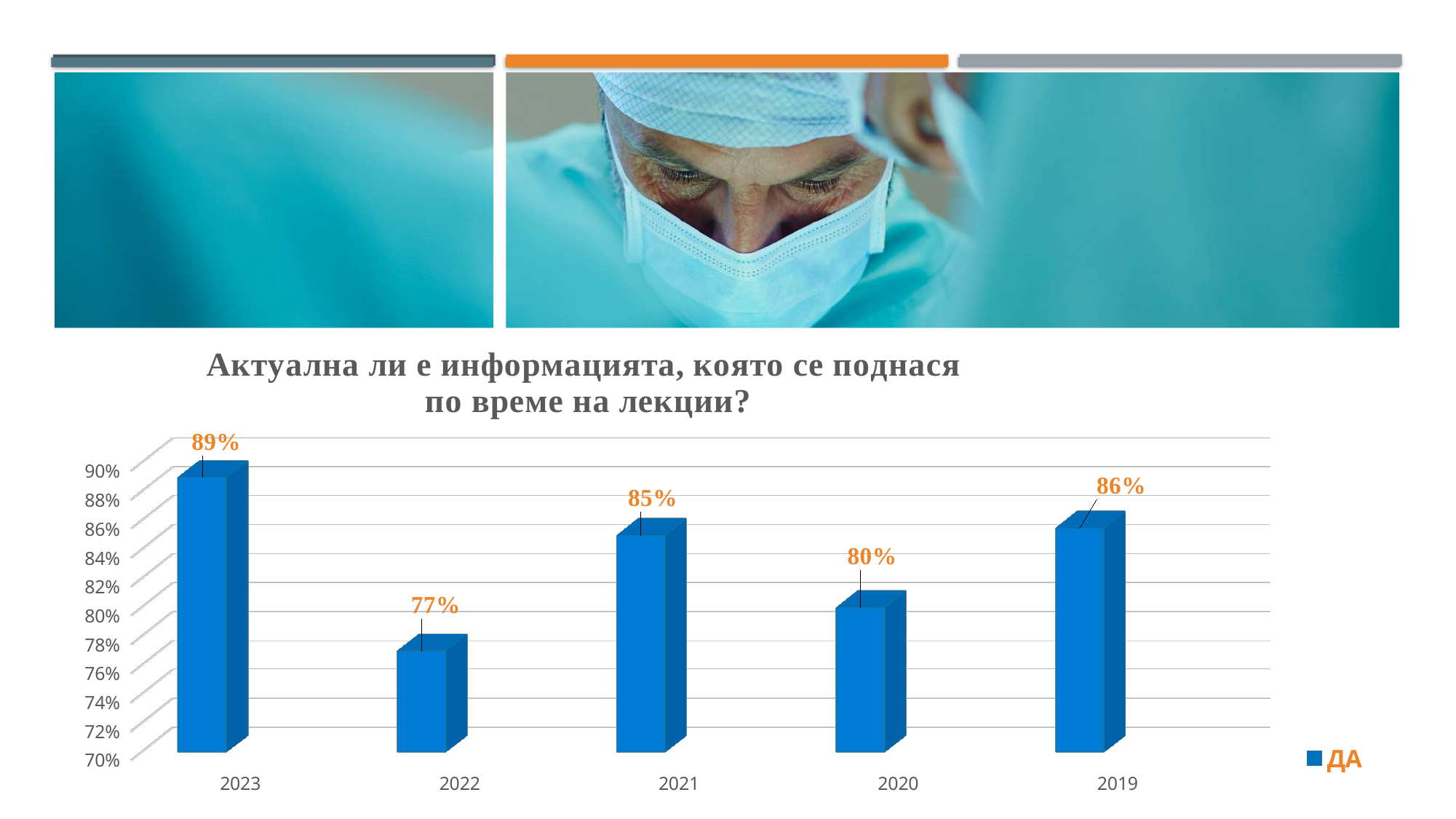
Which year has the highest value? 2023 What is the value for 2023? 89% What is the only legend entry of the chart? ДА Which is larger, the value for 2021 or the value for 2020? 2021 Which year has the lowest value? 2022 What is the difference between the values for 2019 and 2021? 1% What is the difference between the values for 2023 and 2022? 12% How many years are shown on the x axis? 5 What is the value for 2022? 77% Is the value for 2020 greater or less than 84%? less What is the value for 2020? 80% What kind of chart is shown? bar chart